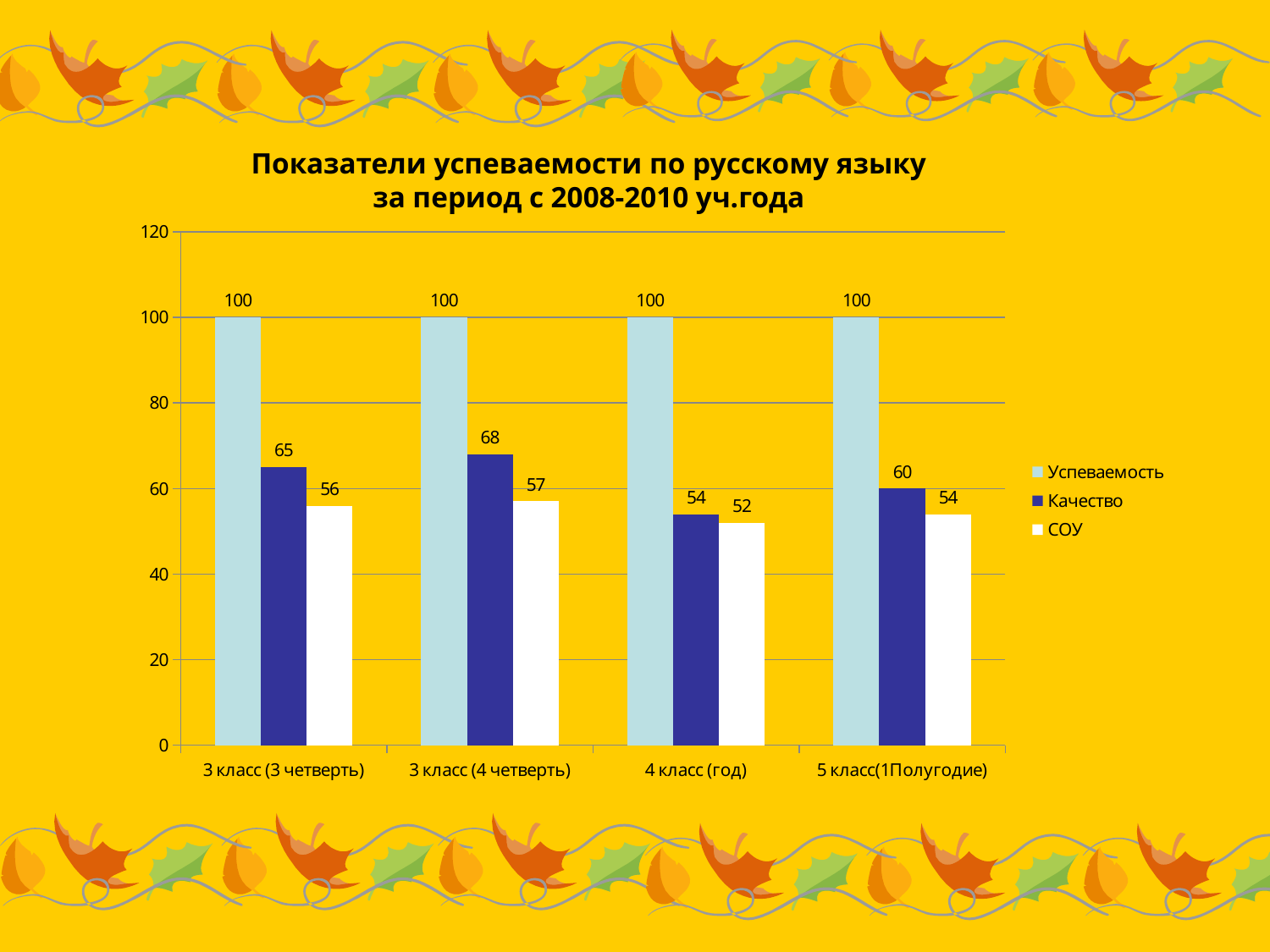
What is the value of СОУ for 4 класс (год)? 52 How many categories are shown on the x axis? 4 Which category has the lowest СОУ value? 4 класс (год) Which is larger: Качество for 5 класс(1Полугодие) or Качество for 4 класс (год)? 5 класс(1Полугодие) What is the value of Качество for 3 класс (4 четверть)? 68 What kind of chart is shown on the slide? bar chart Which series is shown in white? СОУ Which category has the highest Качество value? 3 класс (4 четверть) What is the title of the chart? Показатели успеваемости по русскому языку за период с 2008-2010 уч.года What is the value of Успеваемость for 5 класс(1Полугодие)? 100 What is the difference between Качество and СОУ for 3 класс (3 четверть)? 9 How many series does the legend list? 3